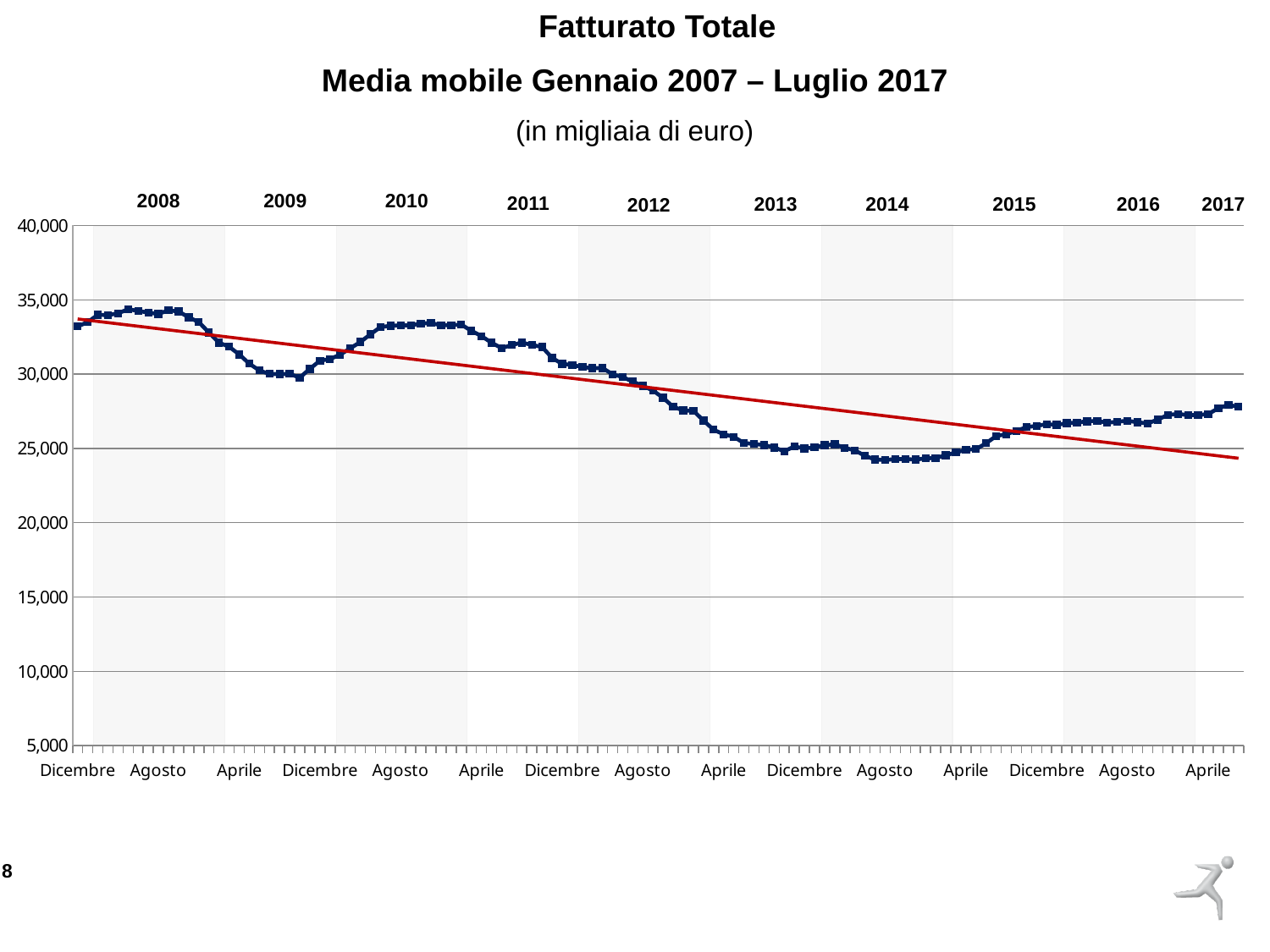
Is the value of the moving average at the start of the series (Dicembre 2007) greater or less than 30,000? greater Does the moving average line generally rise or fall from 2008 to 2017? fall In which labelled year does the moving average reach its lowest point? 2014 Does the red trend line rise or fall along the x axis? fall What is the title of the chart? Fatturato Totale Is the lowest value of the moving average, in 2014, greater or less than 25,000? less Is the value of the moving average at the end of the series (2017) greater or less than 30,000? less In what units are the values on the chart expressed, according to the subtitle? in migliaia di euro How many year labels are shown along the top of the chart? 10 What kind of chart is shown on the slide? line chart Which is larger, the moving average in 2010 or in 2014? 2010 In which labelled year does the moving average reach its highest point? 2008